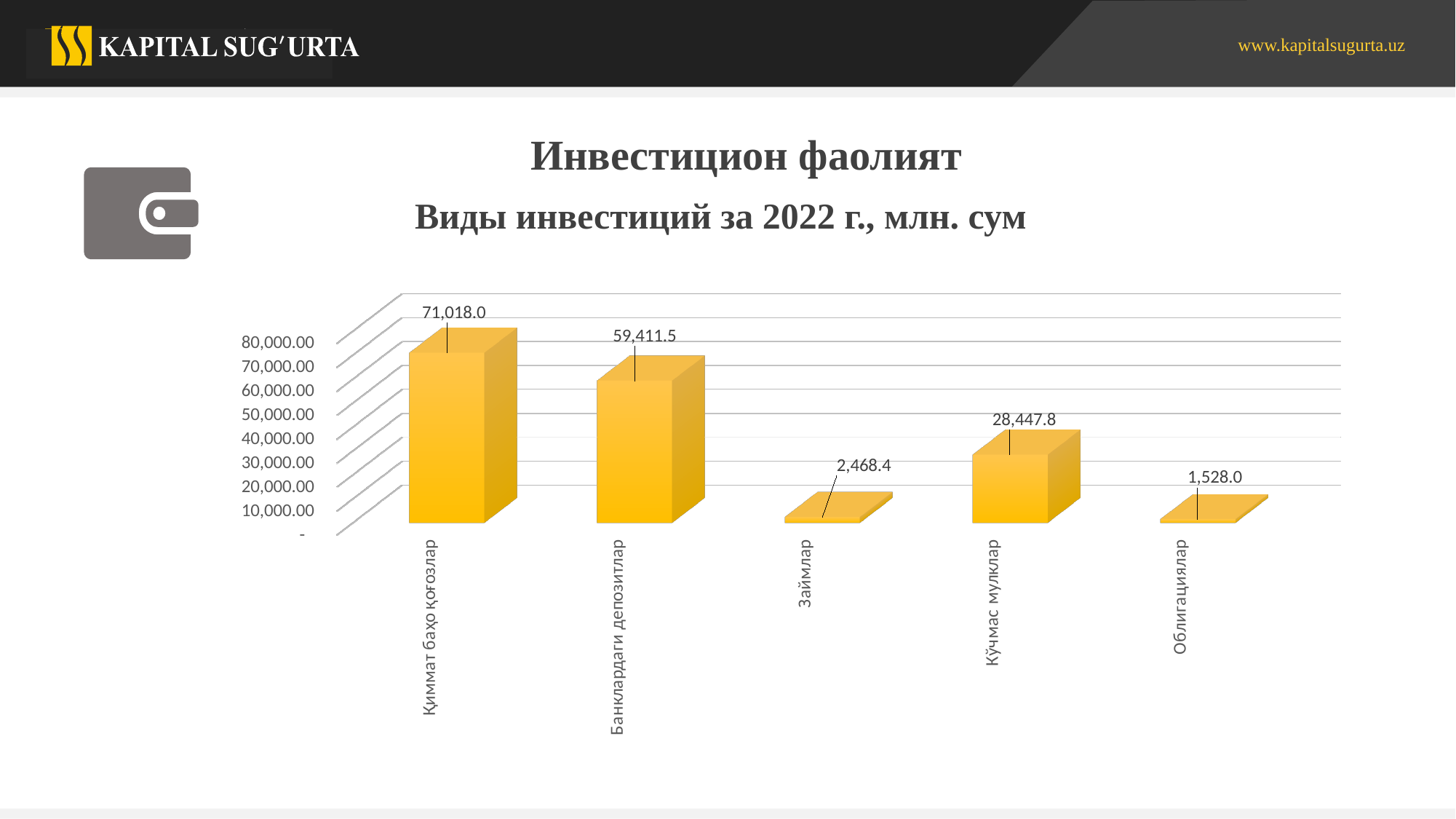
Which category has the highest value? Қиммат баҳо қоғозлар Which is larger, the value for Кўчмас мулклар or the value for Займлар? Кўчмас мулклар What is the value for Банклардаги депозитлар? 59,411.5 What is the difference between the values for Кўчмас мулклар and Займлар? 25,979.4 What is the difference between the values for Қиммат баҳо қоғозлар and Банклардаги депозитлар? 11,606.5 What is the value for Займлар? 2,468.4 What is the value for Кўчмас мулклар? 28,447.8 Which category has the lowest value? Облигациялар What is the value for Қиммат баҳо қоғозлар? 71,018.0 How many categories are shown in the chart? 5 What kind of chart is shown on the slide? Bar chart What is the value for Облигациялар? 1,528.0